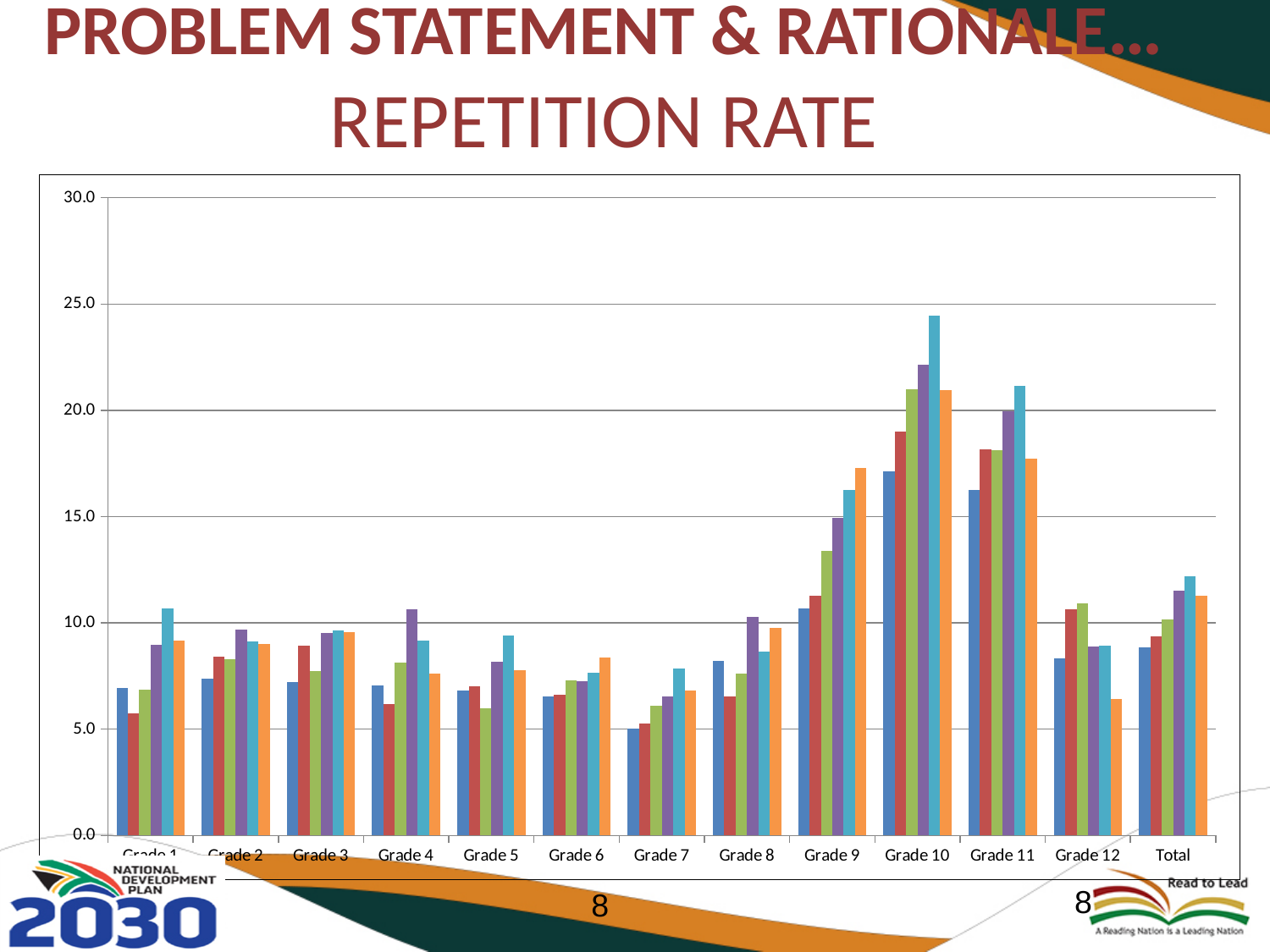
Is the blue bar for Grade 10 greater or less than 15.0? greater What is the highest value shown on the vertical axis of the chart? 30.0 Is the orange bar for Grade 12 greater or less than 10.0? less Do the values rise or fall from Grade 7 to Grade 10? rise Which grade has the tallest bar in the chart? Grade 10 Are all the bars for Grade 7 greater or less than 10.0? less How many bars are plotted for each category in the chart? 6 What kind of chart is shown on the slide? bar chart How many categories are shown along the x axis of the chart? 13 Which has the taller teal bar, Grade 10 or Grade 11? Grade 10 Which grade has the lowest bars in the chart? Grade 7